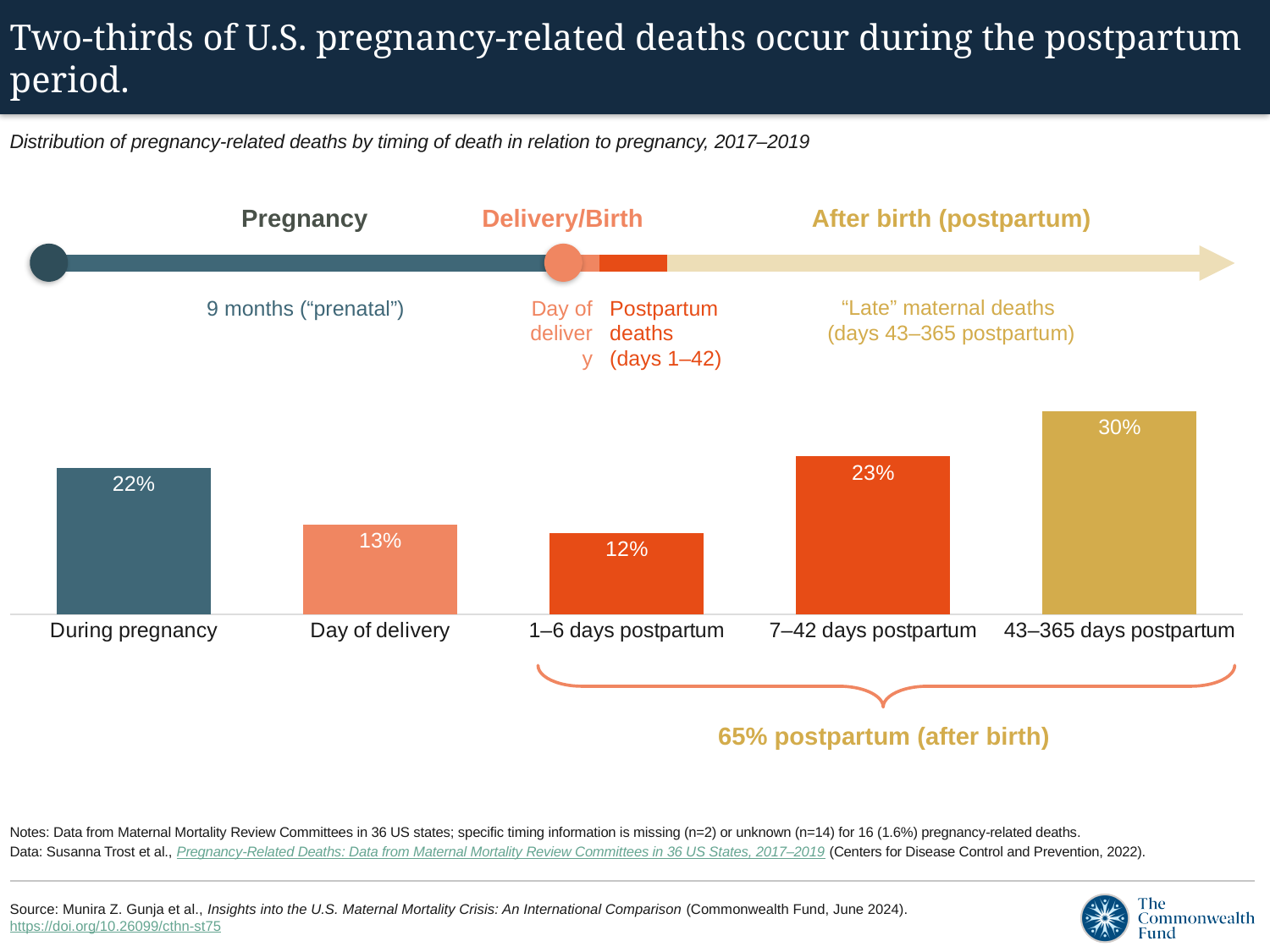
How many timing categories are shown in the bar chart? 5 What percentage of pregnancy-related deaths occurred on the day of delivery? 13% What percentage of pregnancy-related deaths occurred during pregnancy? 22% Which timing category has the highest share of pregnancy-related deaths? 43–365 days postpartum What is the difference between the share for 43–365 days postpartum and the share for 7–42 days postpartum? 7% What is the combined share of pregnancy-related deaths that occurred postpartum (after birth), as labeled on the slide? 65% Which is larger: the share for during pregnancy or the share for day of delivery? During pregnancy What is the value for 1–6 days postpartum? 12% What time period does the chart's subtitle say the data covers? 2017–2019 What is the value for 43–365 days postpartum? 30% Which timing category has the lowest share of pregnancy-related deaths? 1–6 days postpartum What type of chart is shown on the slide? Bar chart